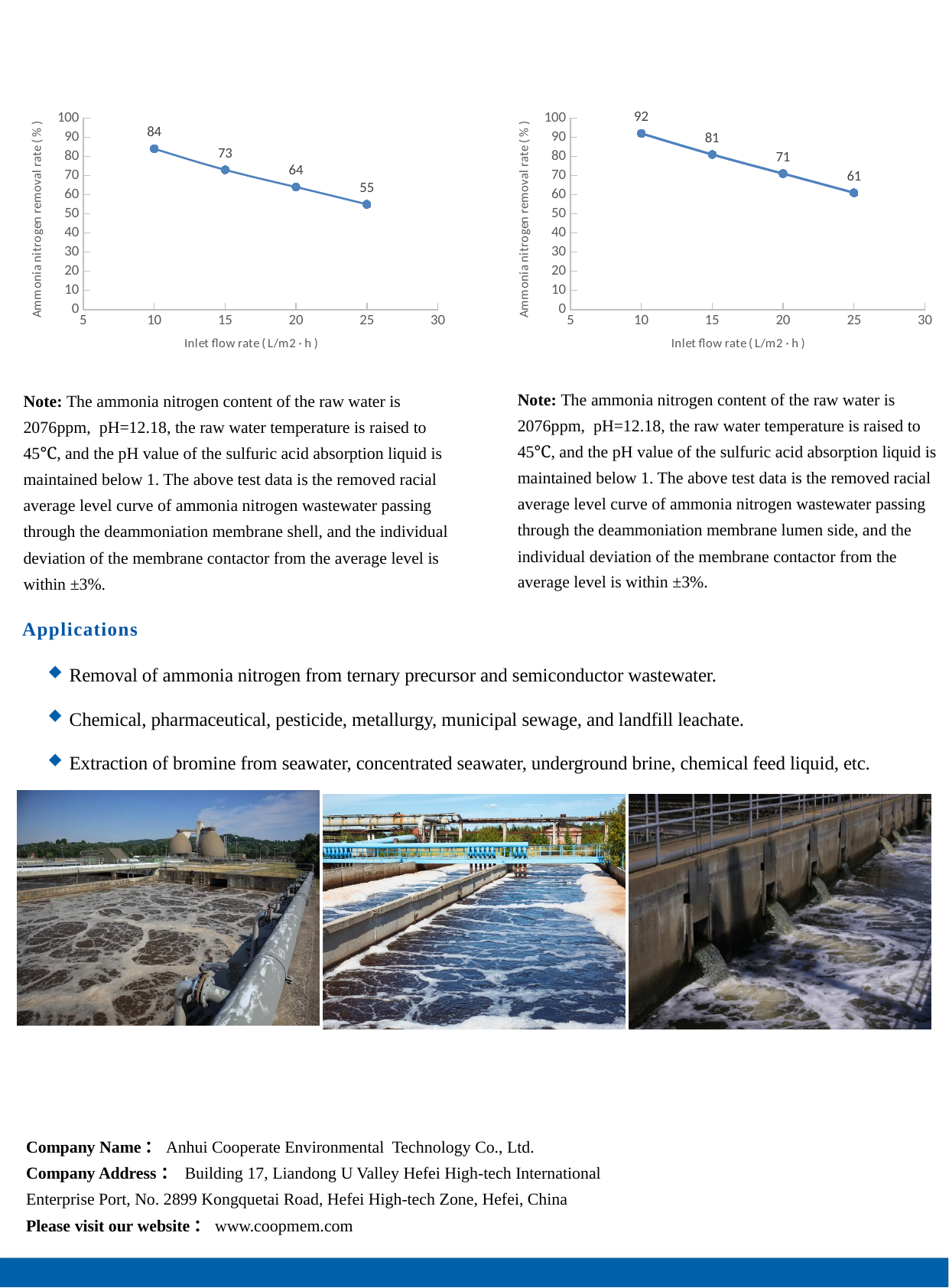
In the left chart, at which inlet flow rate is the removal rate highest? 10 What is the x-axis label of the left chart? Inlet flow rate (L/m2·h) In the left chart, what is the difference between the removal rate at inlet flow rate 10 and at inlet flow rate 25? 29 In the right chart, at which inlet flow rate is the removal rate lowest? 25 In the right chart, what is the difference between the removal rate at inlet flow rate 15 and at inlet flow rate 20? 10 In the left chart, does the removal rate rise or fall as the inlet flow rate increases? Fall Which is larger: the removal rate at inlet flow rate 15 in the left chart or at inlet flow rate 15 in the right chart? Right chart What type of chart is the right chart? Line chart In the left chart, what is the ammonia nitrogen removal rate at an inlet flow rate of 10? 84 In the right chart, what is the ammonia nitrogen removal rate at an inlet flow rate of 25? 61 In the right chart, is the removal rate at inlet flow rate 20 greater or less than 70? greater In the left chart, how many data points are plotted? 4